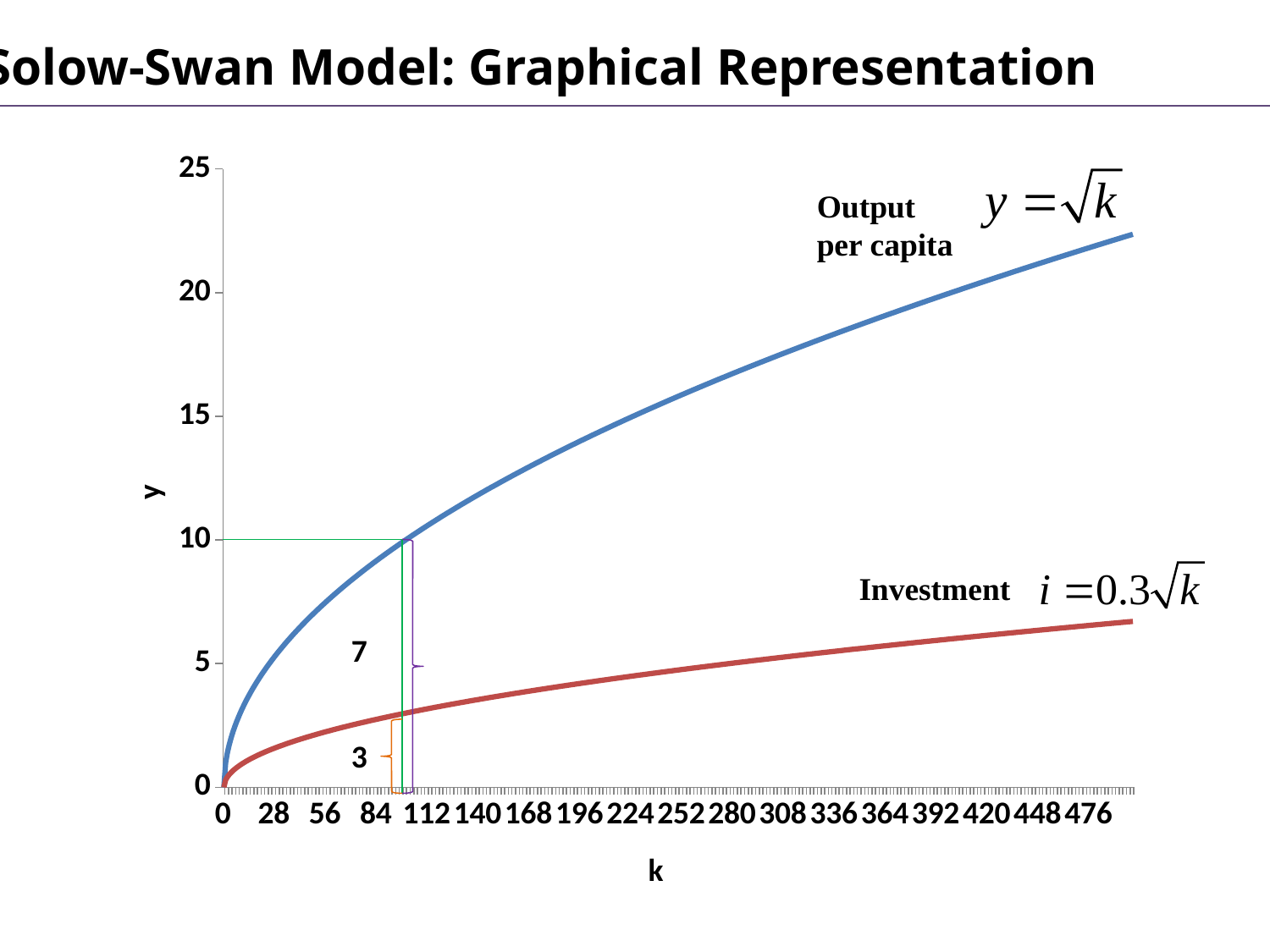
What equation is written next to the Investment curve? i = 0.3√k At k = 476, which curve is higher, Output per capita or Investment? Output per capita What number labels the bracket between the horizontal axis and the Investment curve at the marked point? 3 Is the value of Investment at k = 476 greater or less than 10? less How many curves are plotted on the chart? 2 What kind of chart is shown on the slide? line chart What number labels the bracket between the Investment curve and the Output per capita curve at the marked point? 7 Is the value of Investment at k = 196 greater or less than 5? less Does the Output per capita curve rise or fall as k increases? rise Is the value of Output per capita at k = 196 greater or less than 10? greater Does the Investment curve rise or fall as k increases? rise